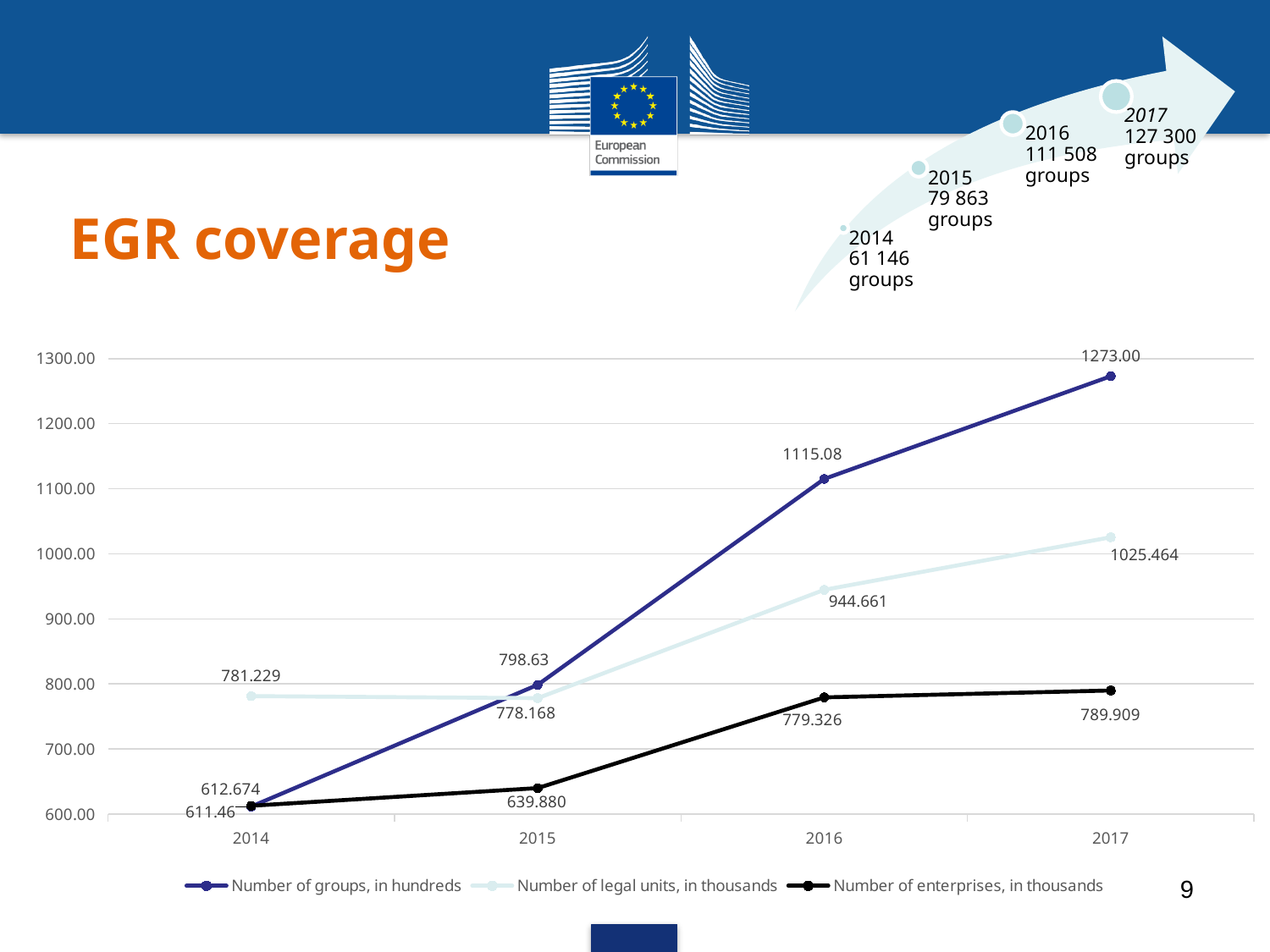
In which year is Number of enterprises, in thousands at its highest? 2017 What is the value for Number of legal units, in thousands in 2016? 944.661 What type of chart is shown on the slide? line chart Does Number of groups, in hundreds rise or fall from 2014 to 2017? rise What is the value for Number of groups, in hundreds in 2016? 1115.08 How many years are plotted along the x axis of the chart? 4 Which is larger in 2015: Number of groups, in hundreds or Number of legal units, in thousands? Number of groups, in hundreds What is the value for Number of enterprises, in thousands in 2015? 639.880 How many series does the chart legend list? 3 What is the value for Number of groups, in hundreds in 2017? 1273.00 In which year is Number of legal units, in thousands at its lowest? 2015 What is the difference between Number of groups, in hundreds in 2017 and in 2016? 157.92